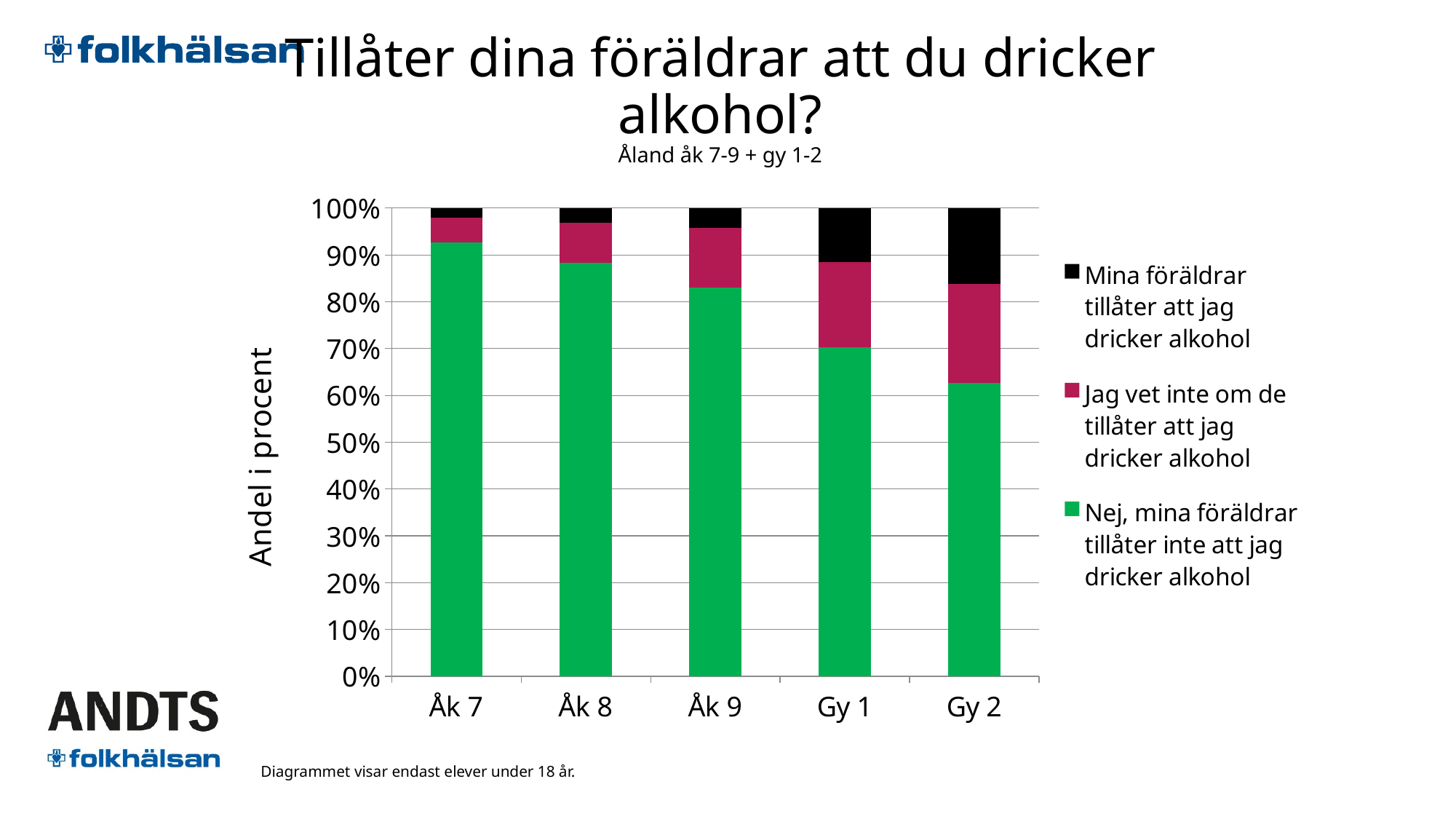
Is the green segment ("Nej, mina föräldrar tillåter inte att jag dricker alkohol") for Gy 1 greater or less than 80%? less Which category has the largest green segment ("Nej, mina föräldrar tillåter inte att jag dricker alkohol")? Åk 7 Is the green segment ("Nej, mina föräldrar tillåter inte att jag dricker alkohol") for Gy 2 greater or less than 70%? less Which category has the largest black segment ("Mina föräldrar tillåter att jag dricker alkohol")? Gy 2 Is the green segment ("Nej, mina föräldrar tillåter inte att jag dricker alkohol") for Åk 9 greater or less than 80%? greater How many categories are shown on the x axis? 5 What kind of chart is shown on the slide? Stacked bar chart What is the label of the y axis? Andel i procent How many series does the legend list? 3 Which category has the smallest green segment ("Nej, mina föräldrar tillåter inte att jag dricker alkohol")? Gy 2 Which has the larger green segment ("Nej, mina föräldrar tillåter inte att jag dricker alkohol"), Åk 8 or Gy 1? Åk 8 Does the share of "Nej, mina föräldrar tillåter inte att jag dricker alkohol" rise or fall from Åk 7 to Gy 2? fall